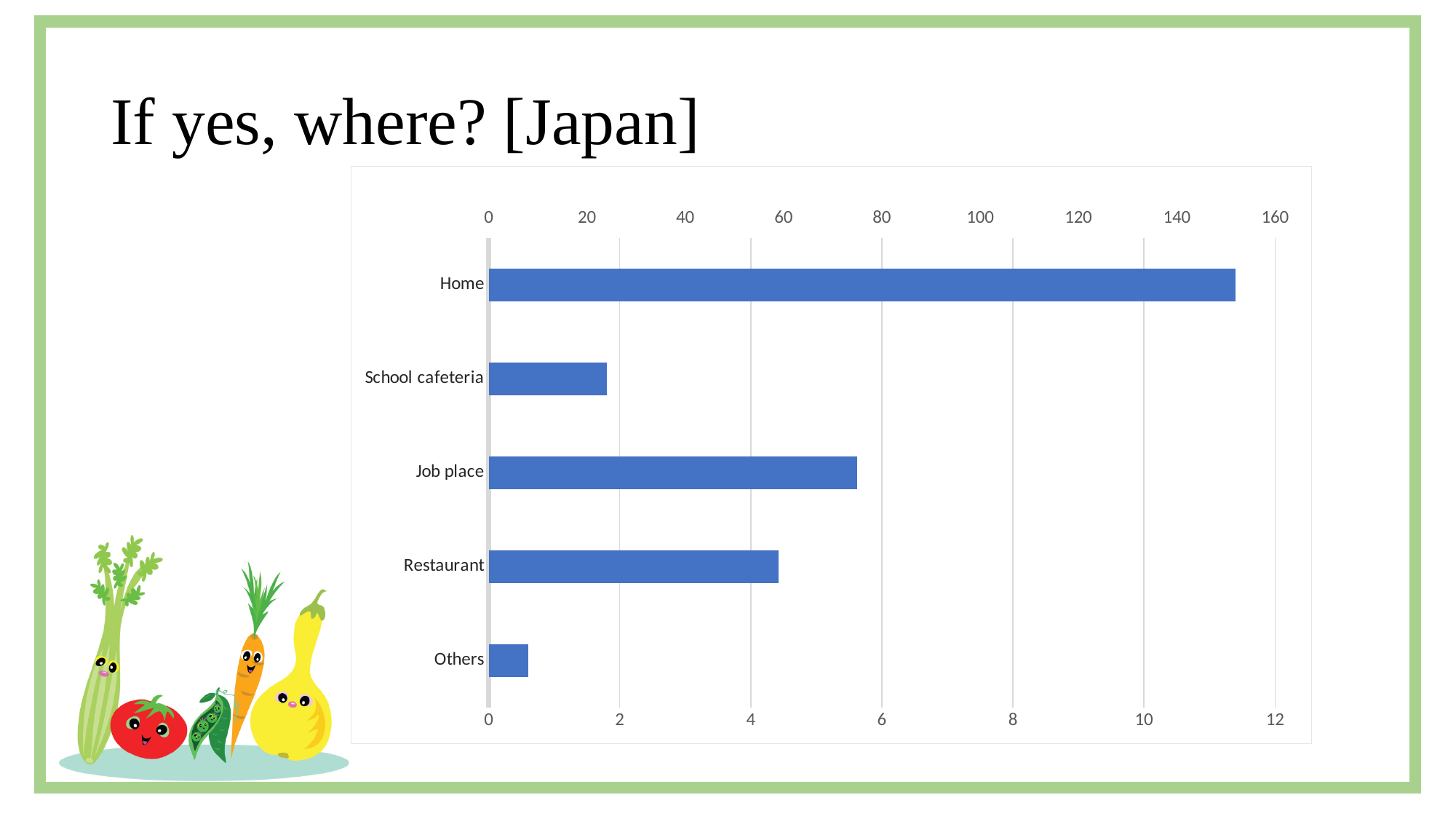
Reading against the top axis (0 to 160), is the value for Home greater or less than 140? greater Reading against the top axis (0 to 160), is the value for Job place greater or less than 40? greater Which has the larger value, Home or Job place? Home What kind of chart is shown on the slide? Bar chart Which has the larger value, Job place or Restaurant? Job place Reading against the top axis (0 to 160), is the value for School cafeteria greater or less than 20? greater How many categories are plotted in the chart? 5 Which category has the lowest value in the chart? Others What is the title of the slide containing the chart? If yes, where? [Japan] Which has the larger value, School cafeteria or Others? School cafeteria Which category has the highest value in the chart? Home What colour are the bars in the chart? Blue